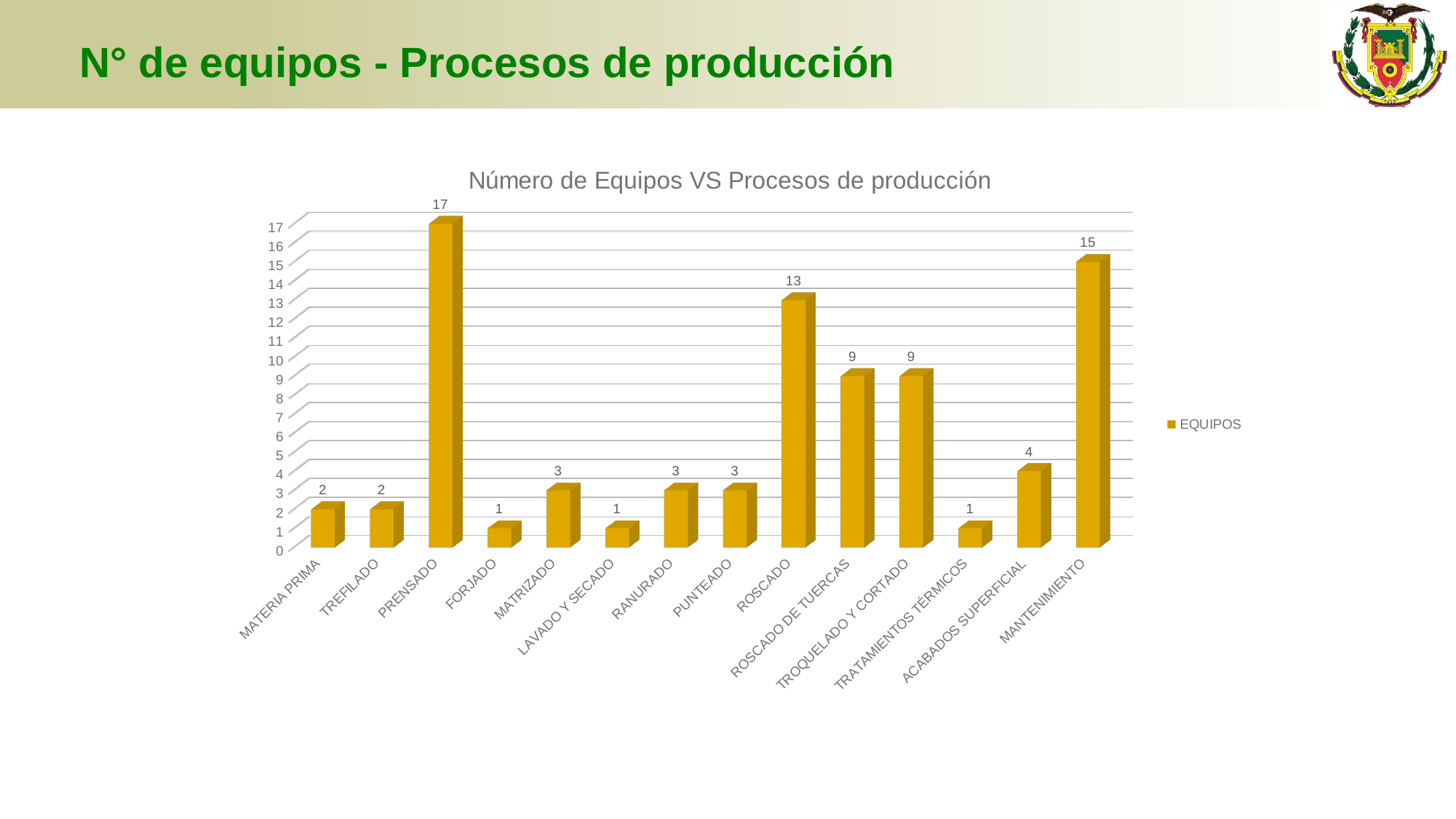
How many series does the legend list? 1 What is the name of the series in the legend? EQUIPOS What is the difference between the values for PRENSADO and MANTENIMIENTO? 2 What is the value for PRENSADO? 17 What is the value for MANTENIMIENTO? 15 What is the title of the chart? Número de Equipos VS Procesos de producción What is the value for ROSCADO? 13 What is the value for ACABADOS SUPERFICIAL? 4 What kind of chart is shown? bar chart Which is larger, the value for ROSCADO or the value for ROSCADO DE TUERCAS? ROSCADO How many categories are shown on the x axis? 14 Which category has the highest value? PRENSADO